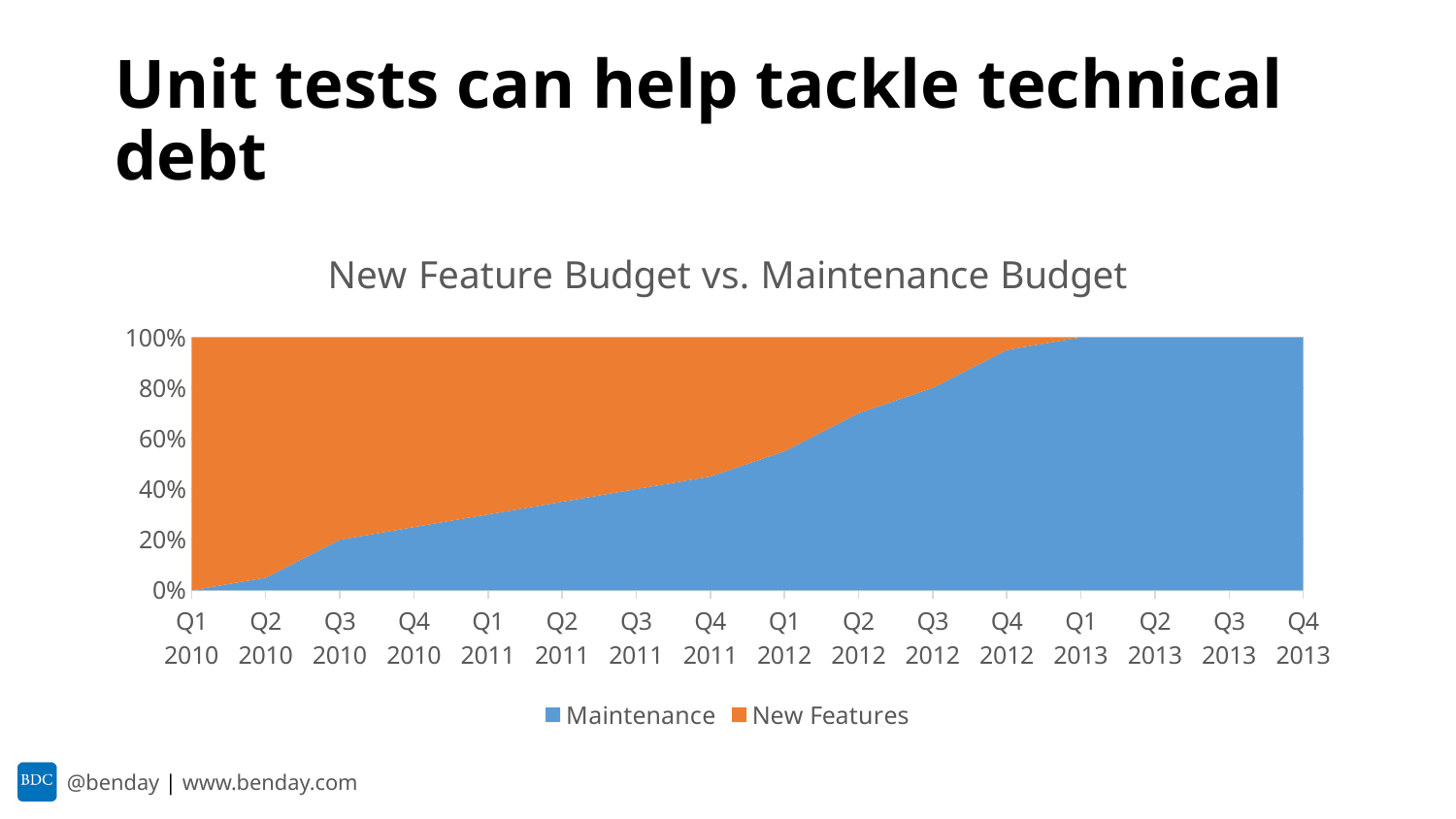
Is the Maintenance share in Q4 2011 greater or less than 60%? less Which colour represents the Maintenance series? Blue What type of chart is shown on the slide? Area chart How many quarters are shown along the x axis? 16 Is the Maintenance share in Q3 2010 greater or less than 40%? less Does the New Features share rise or fall from Q1 2010 to Q4 2013? Fall Does the Maintenance share rise or fall from Q1 2010 to Q4 2013? Rise What is the title of the chart? New Feature Budget vs. Maintenance Budget Which quarter has the lowest Maintenance share? Q1 2010 Is the Maintenance share in Q2 2012 greater or less than 60%? greater How many series does the legend list? 2 What share of the budget goes to Maintenance in Q4 2013? 100%